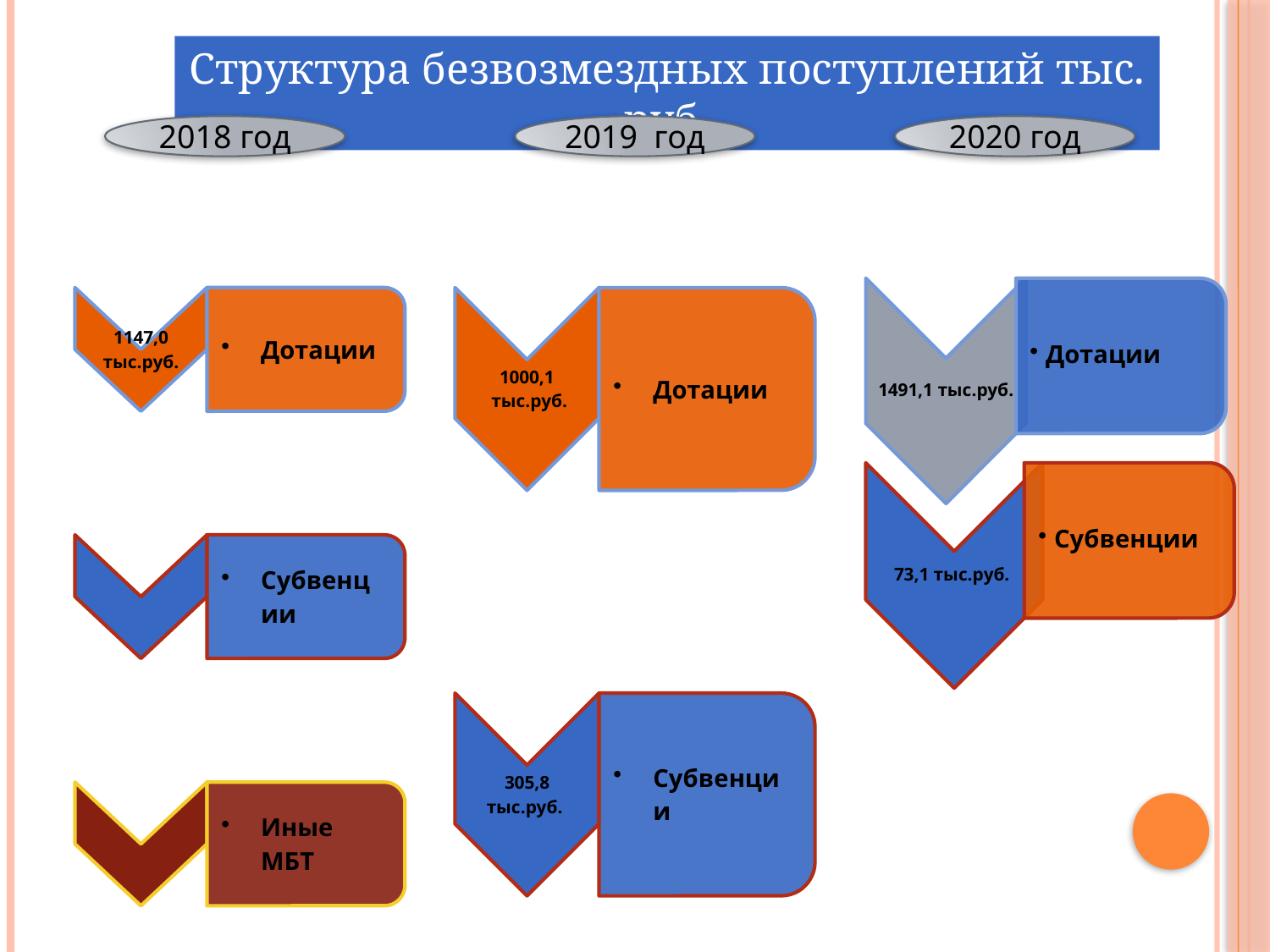
In which year is the value for Дотации the lowest? 2019 год In which year is the value for Дотации the highest? 2020 год What is the value shown for Субвенции in 2019? 305,8 тыс.руб. How many years are shown on the slide? 3 What is the value shown for Дотации in 2018? 1147,0 тыс.руб. Which is larger in 2020, Дотации or Субвенции? Дотации What is the value shown for Субвенции in 2020? 73,1 тыс.руб. What is the difference between Дотации in 2020 and Дотации in 2018? 344,1 тыс.руб. What is the value shown for Дотации in 2020? 1491,1 тыс.руб. What is the difference between Дотации and Субвенции in 2020? 1418,0 тыс.руб. What is the value shown for Дотации in 2019? 1000,1 тыс.руб. What is the title of the slide? Структура безвозмездных поступлений тыс. руб.